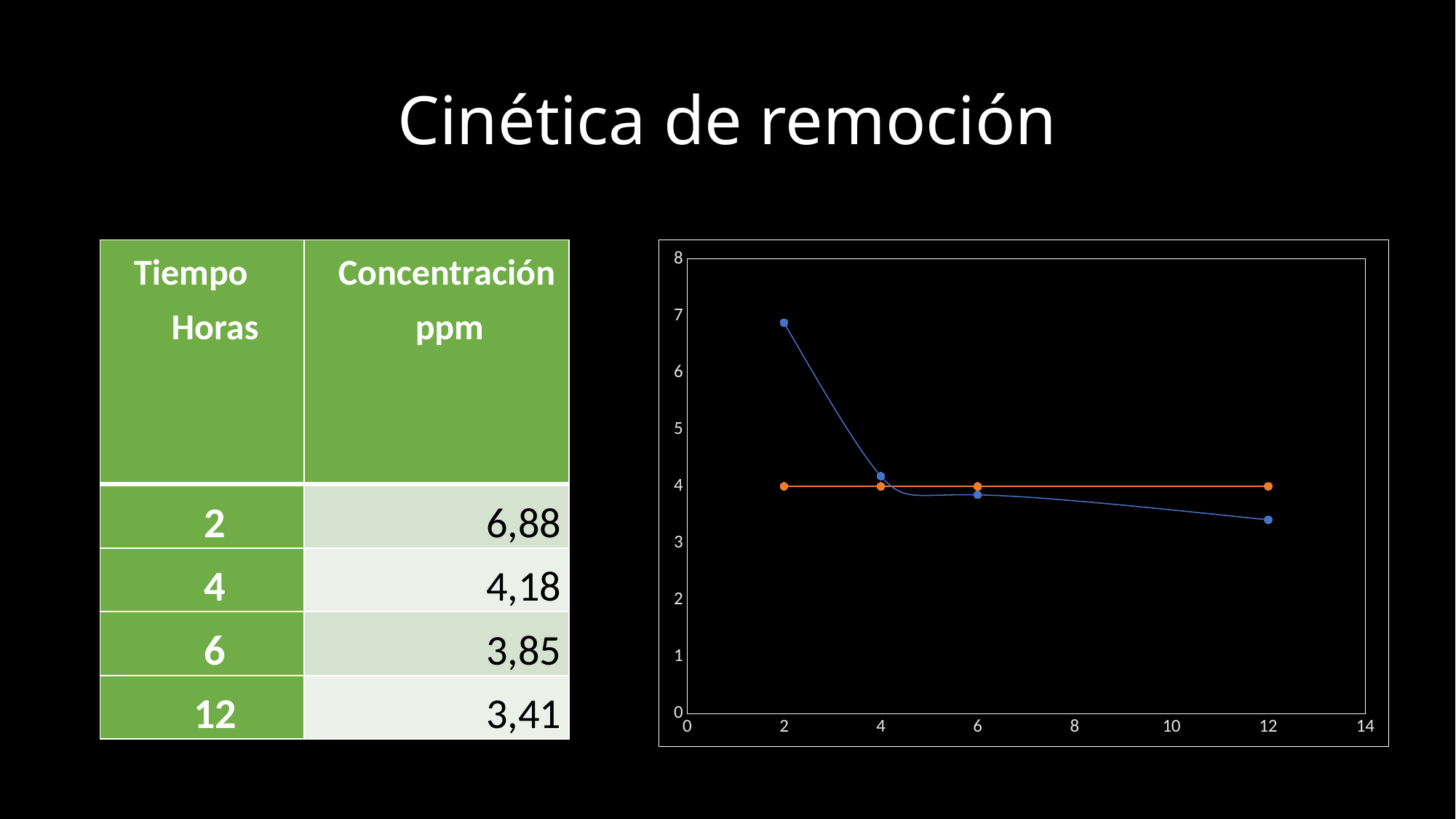
Is the value of the blue series at x = 2 greater or less than 6? greater How many data points does the blue series have in the chart? 4 Does the orange series rise, fall or stay flat across the x axis? stay flat At which x value does the blue series reach its highest point? 2 Does the blue series rise or fall as the x value increases from 2 to 12? fall Is the value of the blue series at x = 12 greater or less than 4? less At x = 2, which series has the larger value, blue or orange? blue What kind of chart is shown on the right of the slide? line chart At which x value does the blue series reach its lowest point? 12 Is the value of the blue series at x = 4 greater or less than 5? less How many series are plotted in the chart? 2 What is the highest tick value shown on the chart's y axis? 8